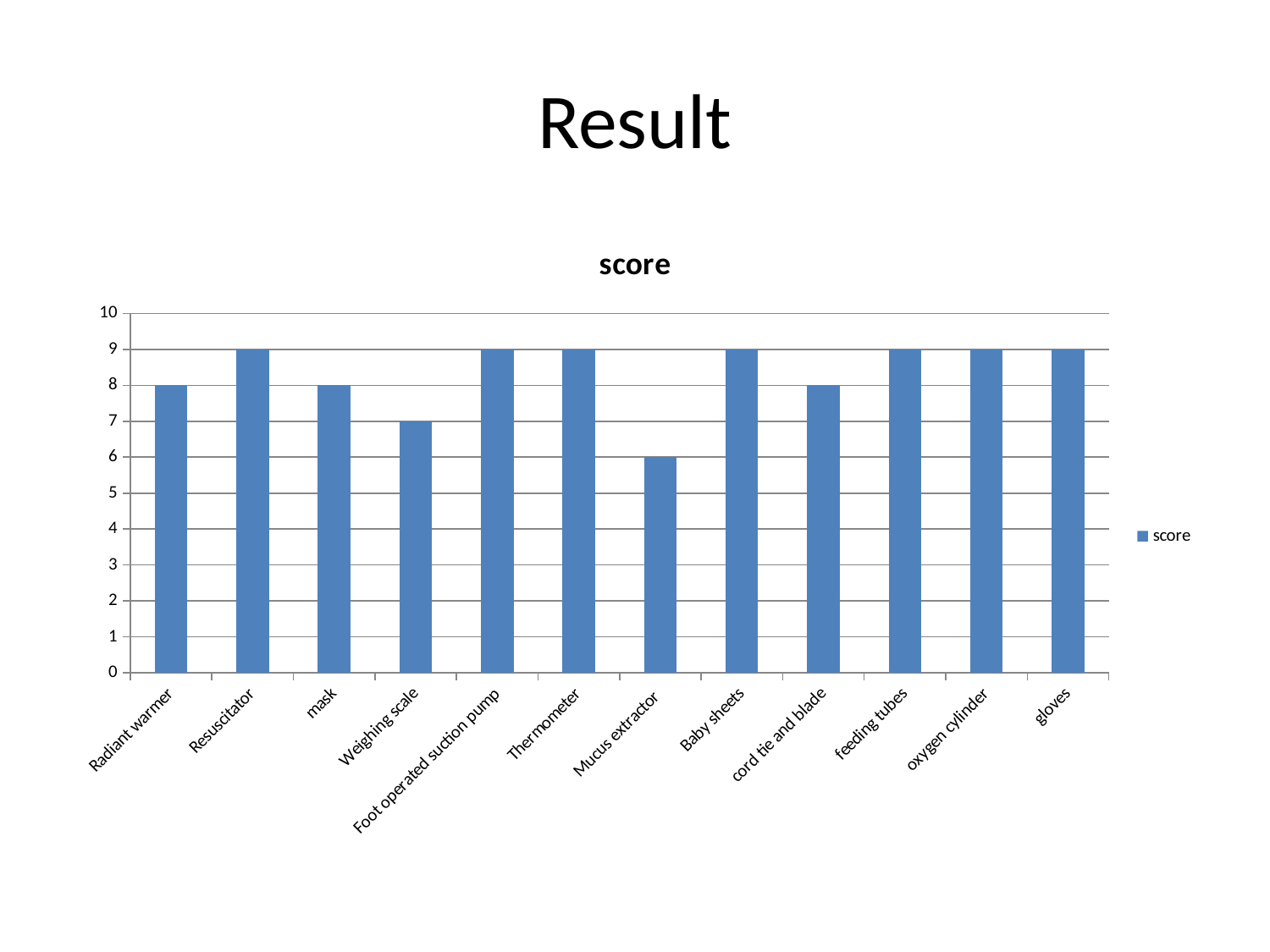
What is the difference between the score for Resuscitator and the score for Mucus extractor? 3 What is the title of the chart? score What is the score for Mucus extractor? 6 What is the score for Radiant warmer? 8 Is the score for Mucus extractor greater or less than 7? less What kind of chart is shown on the slide? bar chart What is the score for Weighing scale? 7 Which category has the lowest score? Mucus extractor What is the difference between the score for cord tie and blade and the score for Weighing scale? 1 How many categories are shown on the x axis? 12 What is the score for Thermometer? 9 Which has a higher score, mask or Weighing scale? mask